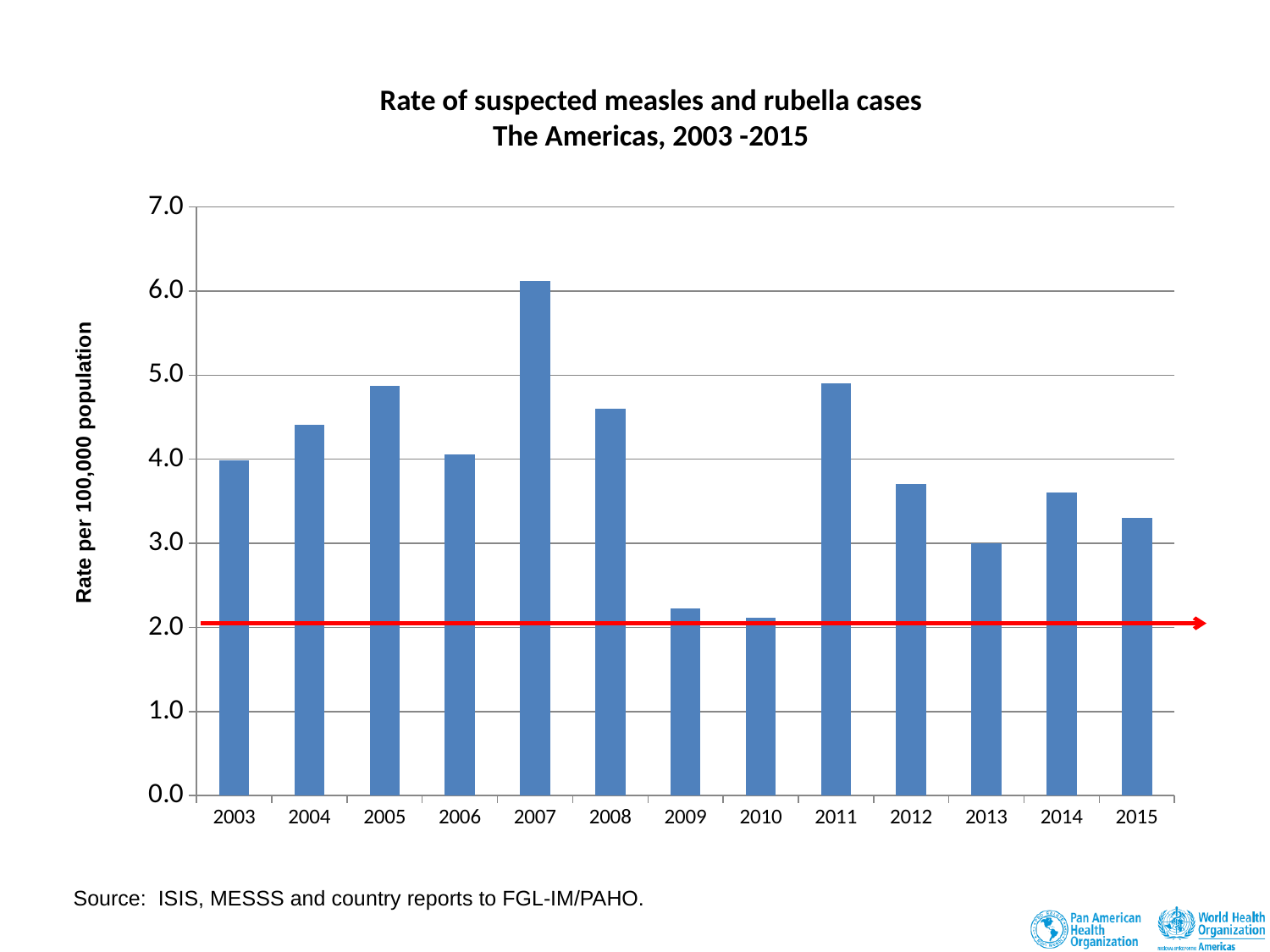
What is the label of the vertical axis? Rate per 100,000 population Which year has the highest rate of suspected measles and rubella cases? 2007 Is the value for 2008 greater or less than 4.0? greater Is the value for 2009 greater or less than 3.0? less How many years are plotted on the x axis of the chart? 13 Which is larger, the value for 2014 or the value for 2015? 2014 Is the value for 2007 greater or less than 5.0? greater Which is larger, the value for 2007 or the value for 2011? 2007 What kind of chart is shown on the slide? bar chart Do the values rise or fall from 2011 to 2013? fall